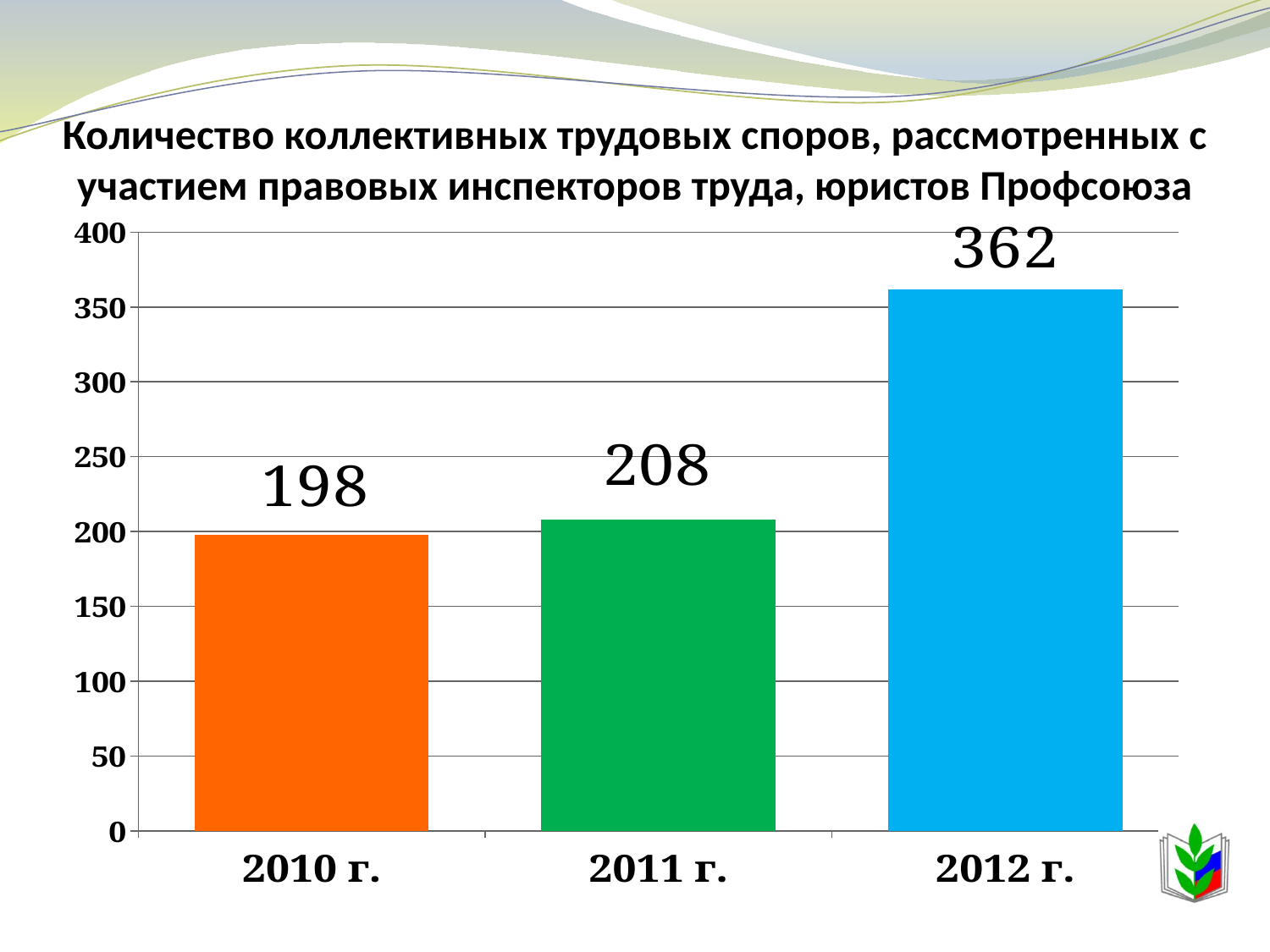
Which year has the lowest value? 2010 г. What is the value for 2012 г.? 362 What is the difference between the values for 2011 г. and 2010 г.? 10 How many years are shown on the chart? 3 Which is larger, the value for 2012 г. or the value for 2010 г.? 2012 г. Is the value for 2012 г. greater or less than 350? greater What kind of chart is shown on the slide? bar chart What is the difference between the values for 2012 г. and 2011 г.? 154 Do the values rise or fall from 2010 г. to 2012 г.? rise Which year has the highest value? 2012 г. What is the value for 2010 г.? 198 What is the value for 2011 г.? 208